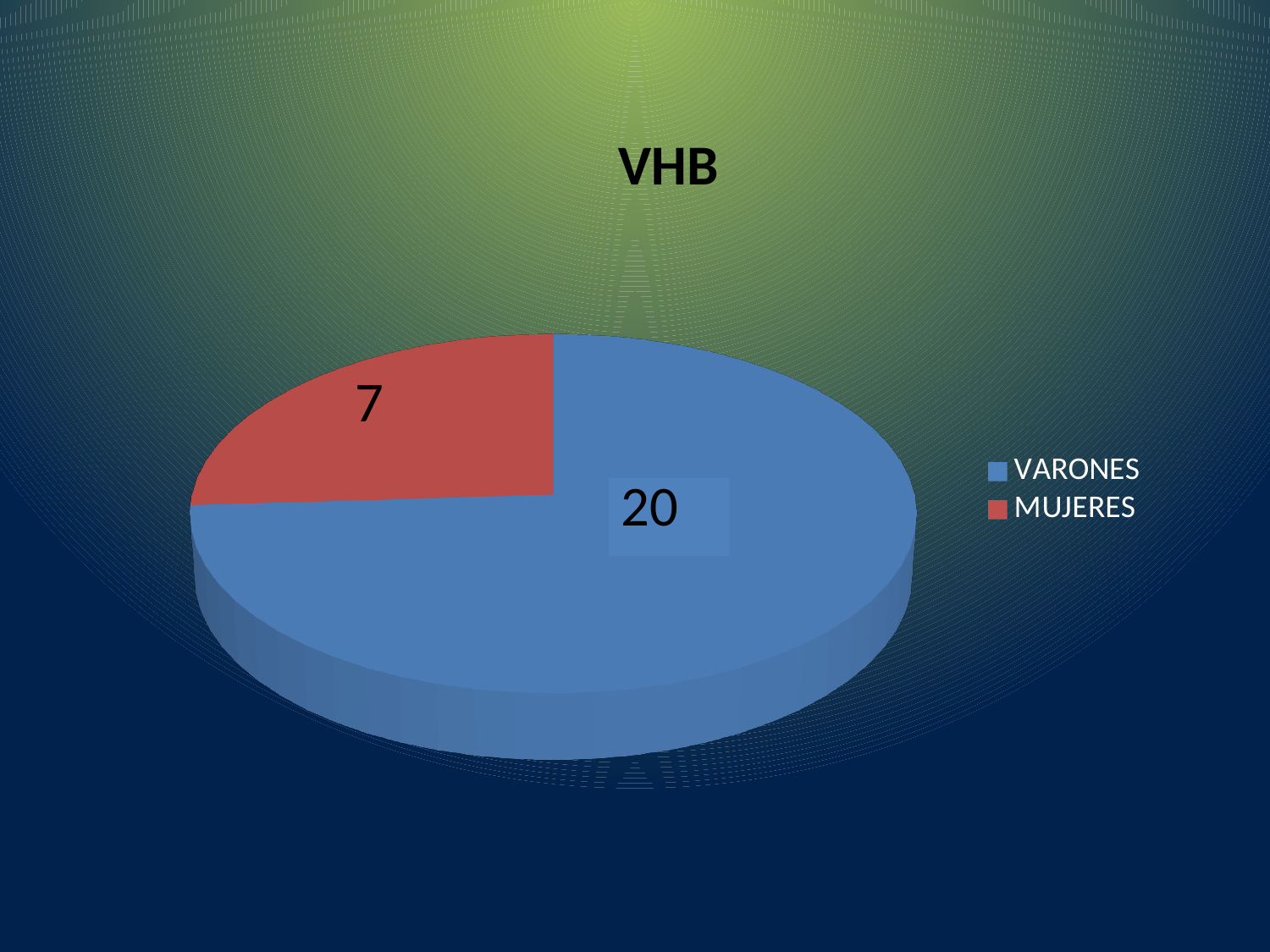
How many categories does the pie chart show? 2 What is the title of the chart? VHB What is the total of all slices in the pie chart? 27 What kind of chart is shown on the slide? Pie chart Which category has the smallest slice? MUJERES What is the difference between the values for VARONES and MUJERES? 13 Which category has the largest slice? VARONES Which is larger, VARONES or MUJERES? VARONES What is the value for VARONES? 20 What colour is the MUJERES slice? Red What is the value for MUJERES? 7